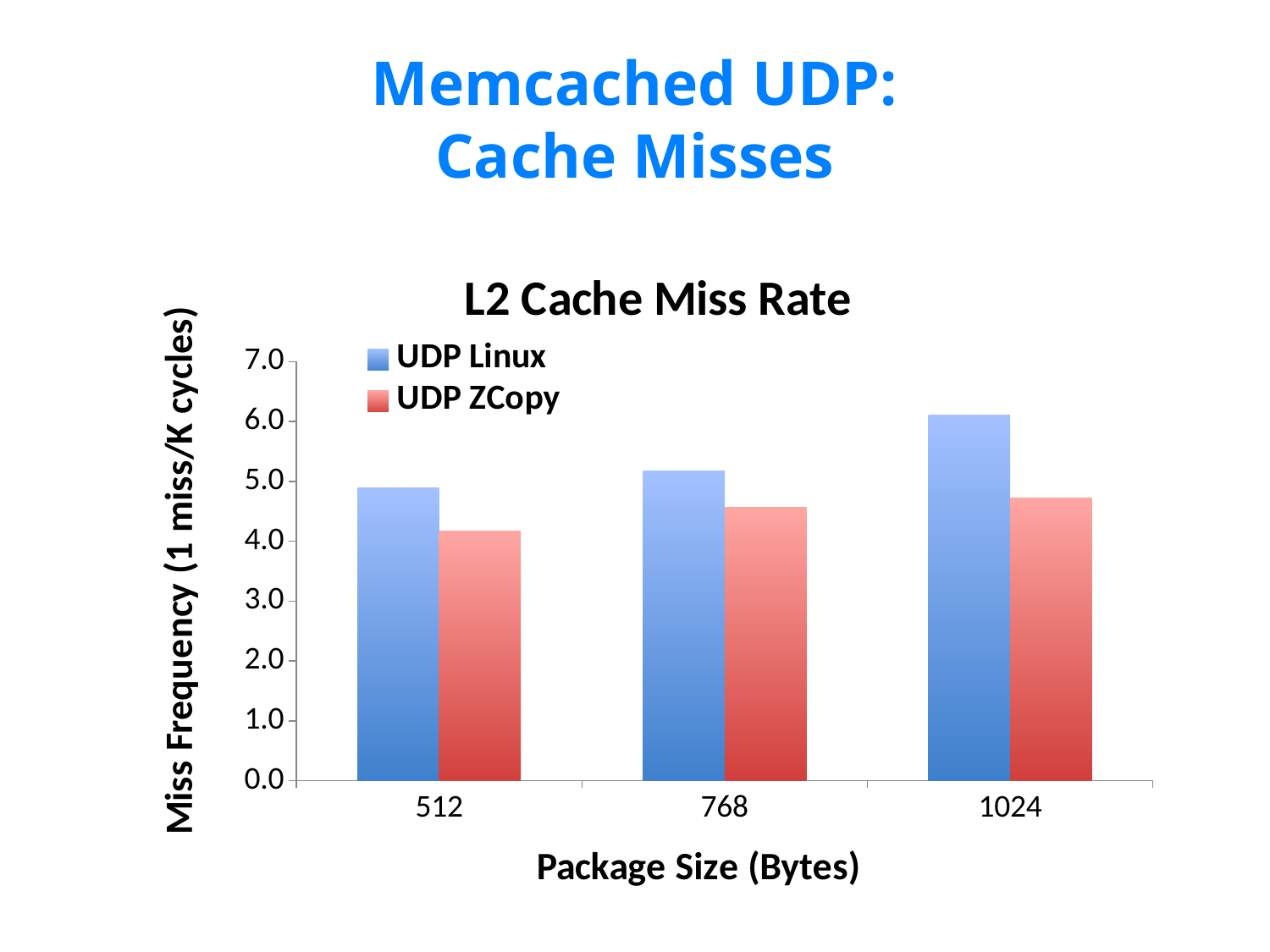
Is the UDP ZCopy value at package size 1024 greater or less than 5.0? less Do the UDP Linux values rise or fall as package size increases? rise Is the UDP ZCopy value at package size 512 greater or less than 4.0? greater At which package size is the UDP Linux miss frequency highest? 1024 What kind of chart is shown on the slide? bar chart What is the title of the chart? L2 Cache Miss Rate At package size 512, which series has the higher miss frequency, UDP Linux or UDP ZCopy? UDP Linux How many series does the legend list? 2 Is the UDP Linux value at package size 1024 greater or less than 5.0? greater What is the label of the x axis? Package Size (Bytes) How many package sizes are shown on the x axis? 3 At which package size is the UDP ZCopy miss frequency lowest? 512